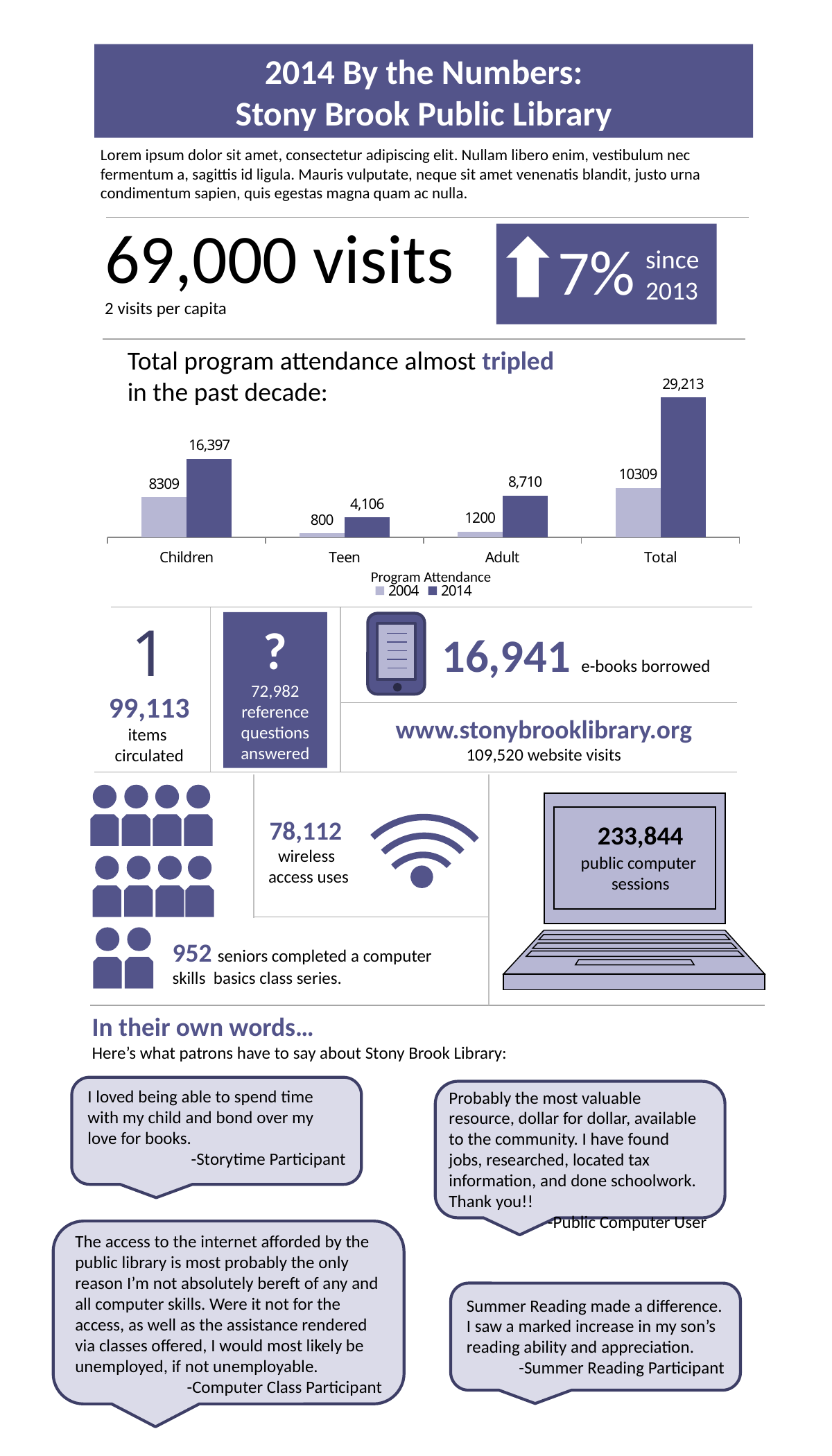
What is the difference between the 2014 and 2004 Total program attendance? 18,904 Which category has the lowest 2014 program attendance? Teen How many series does the chart legend list? 2 What is the 2004 program attendance for Teen? 800 What is the 2014 program attendance for Children? 16,397 What is the 2014 program attendance for Adult? 8,710 What type of chart is shown on the slide? bar chart Excluding Total, which category has the highest 2004 program attendance? Children Which is larger: the 2014 attendance for Teen or the 2004 attendance for Children? 2004 attendance for Children What is the 2004 value for Total program attendance? 10309 How many categories are shown on the x axis of the chart? 4 What is the difference between the 2014 and 2004 program attendance for Adult? 7,510